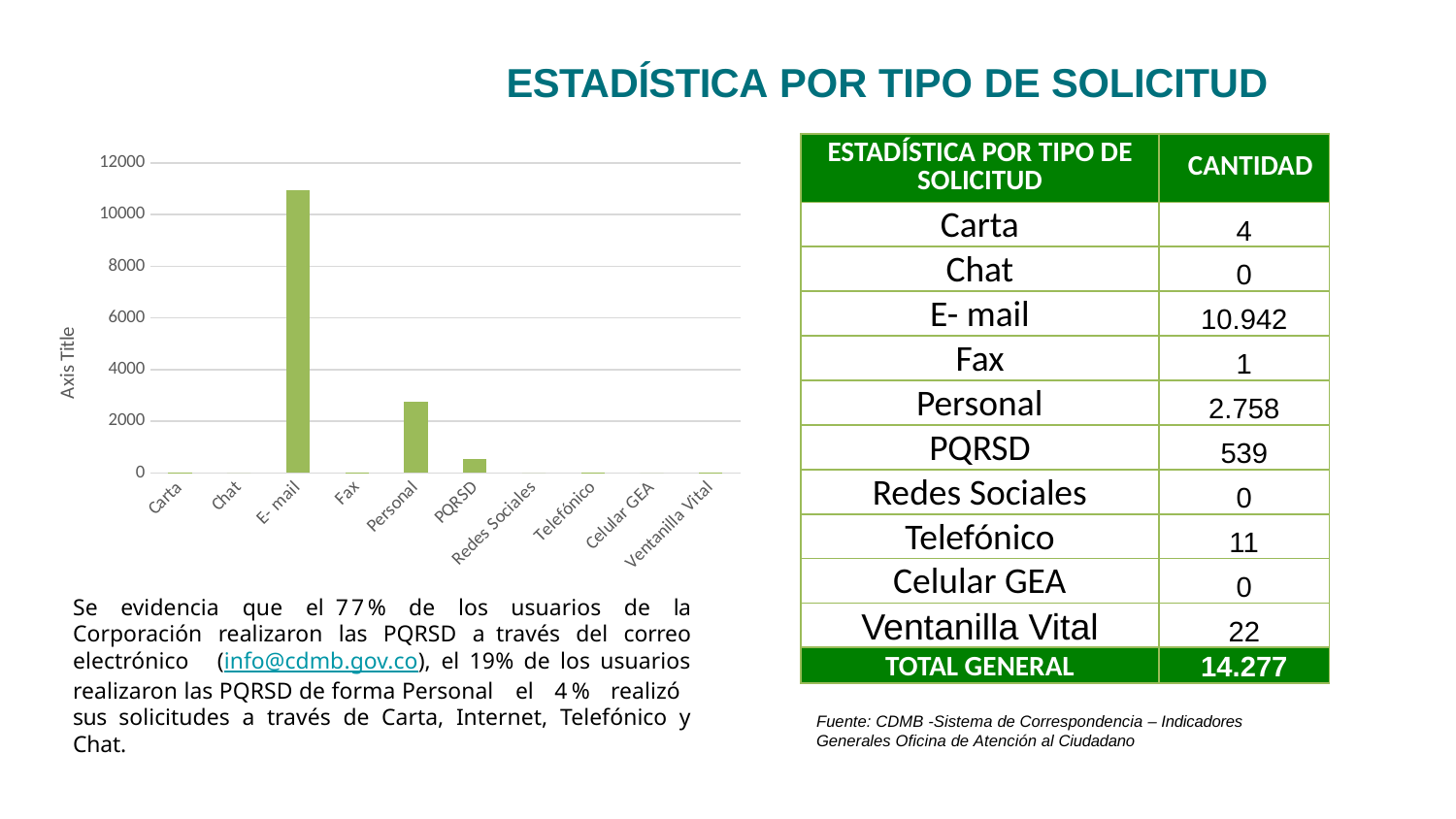
What kind of chart is shown on the slide? bar chart Is the value for E- mail greater or less than 10000? greater How many categories are shown on the x axis of the chart? 10 What is the highest tick value shown on the chart's vertical axis? 12000 Which is larger, the value for Personal or the value for PQRSD? Personal What is the total general shown in the table? 14.277 According to the table, what is the quantity for E- mail? 10.942 According to the table, what is the quantity for Ventanilla Vital? 22 Is the value for Personal greater or less than 4000? less Is the value for PQRSD greater or less than 2000? less What is the difference between the E- mail value and the Personal value shown in the table? 8.184 Which category has the highest bar in the chart? E- mail